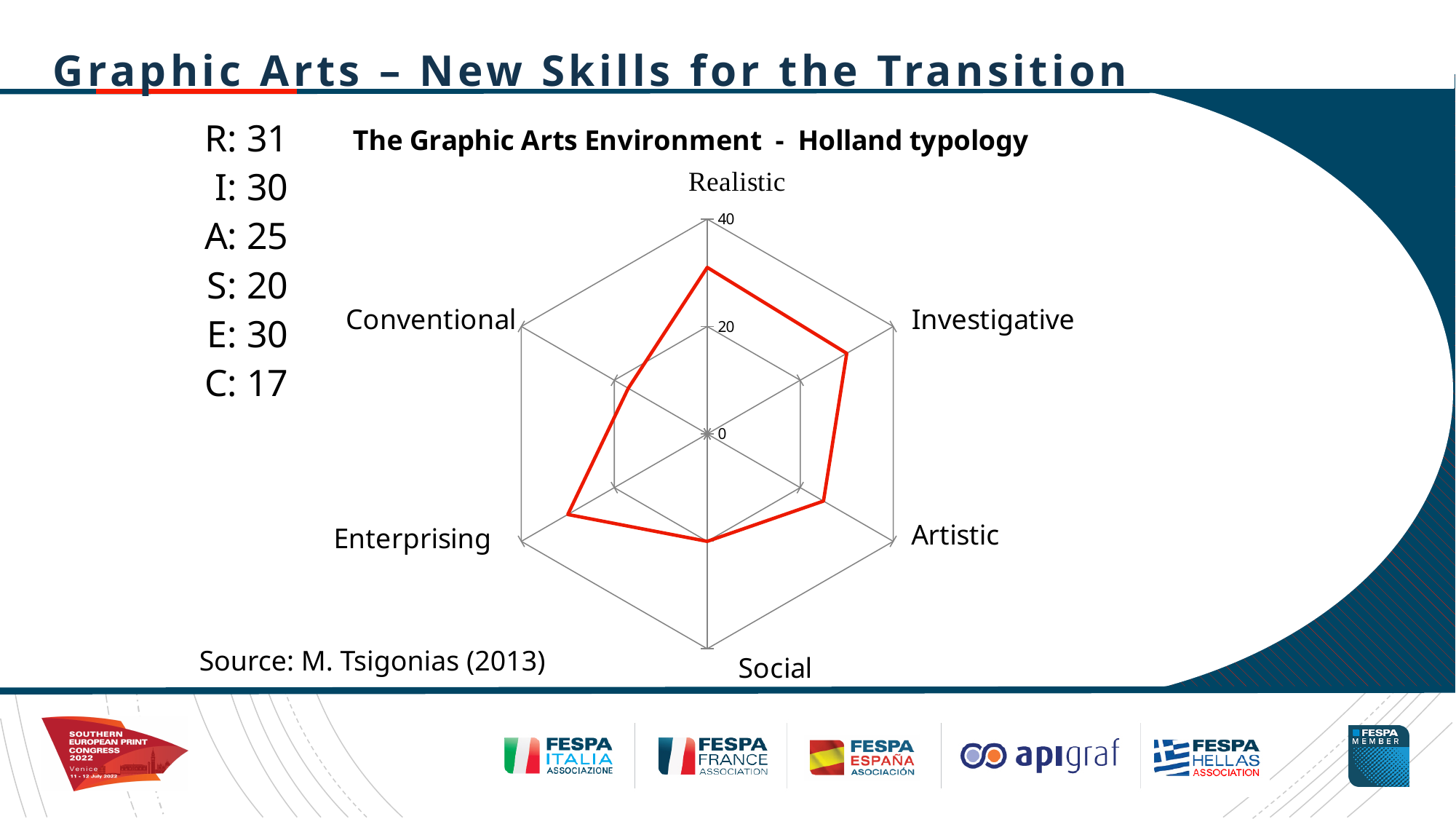
What is the difference between the Investigative and Social values? 10 How many categories (axes) does the radar chart have? 6 What is the difference between the Realistic and Conventional values? 14 What kind of chart is shown on the slide? Radar chart What is the value for Conventional? 17 Is the value for Conventional greater or less than 20? less What is the value for Artistic? 25 Which is larger, the value for Artistic or the value for Social? Artistic Which category has the lowest value? Conventional What is the value for Realistic? 31 What is the title of the chart? The Graphic Arts Environment - Holland typology Which category has the highest value? Realistic